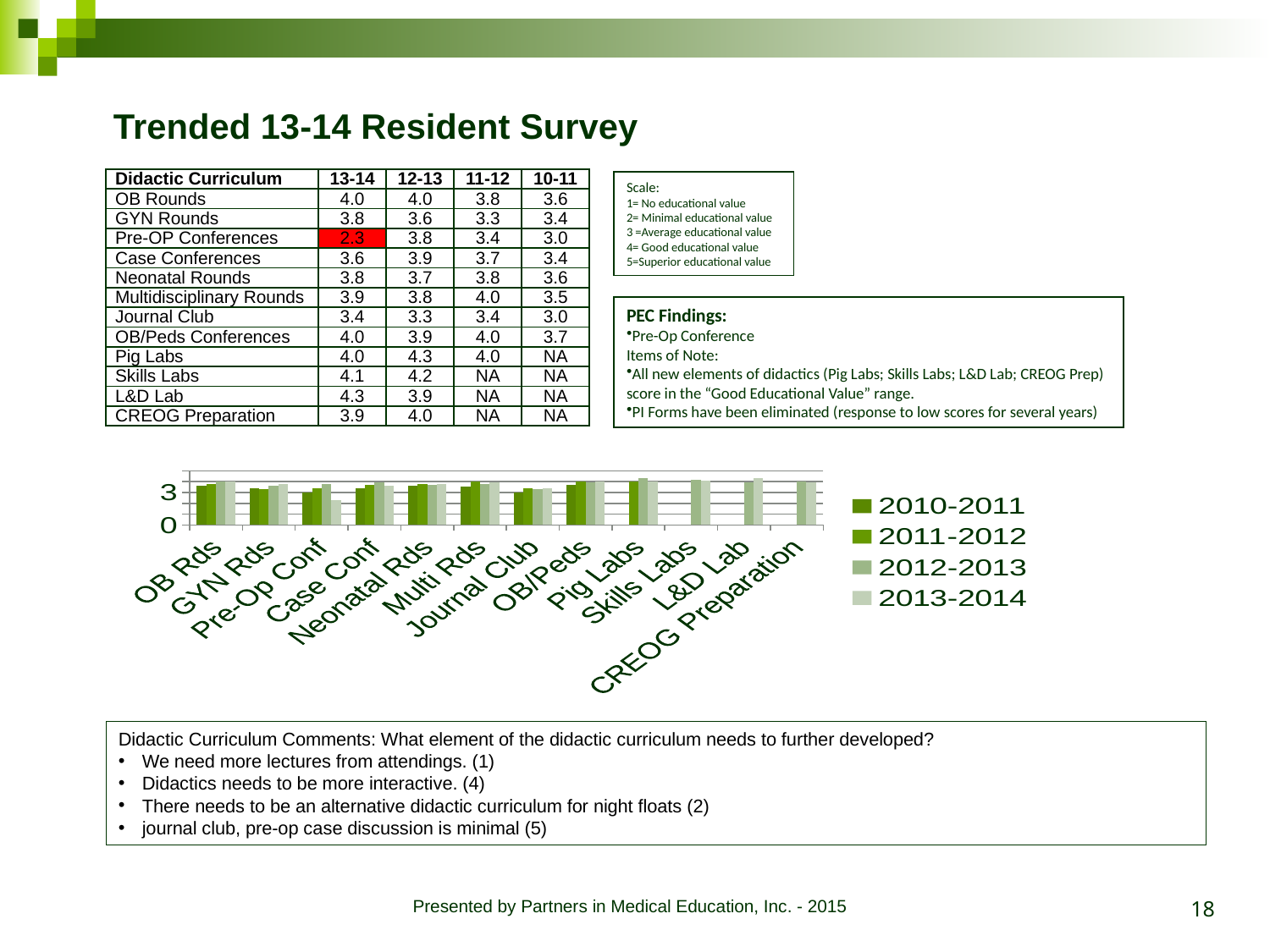
In the bar chart, is the 2013-2014 value for OB Rds greater or less than 3? greater In the bar chart, is the 2013-2014 value for Pre-Op Conf greater or less than 3? less How many categories in the bar chart have bars for only two of the four series? 3 How many categories are shown along the x axis of the bar chart? 12 In the bar chart, is the 2013-2014 value for L&D Lab greater or less than 3? greater In the bar chart, which category has the lowest 2013-2014 bar? Pre-Op Conf In the bar chart, which is larger for Pre-Op Conf: the 2012-2013 bar or the 2013-2014 bar? 2012-2013 How many series does the legend of the bar chart list? 4 Which categories in the bar chart have no bars for 2010-2011 and 2011-2012? Skills Labs, L&D Lab, CREOG Preparation What kind of chart is shown on the slide? bar chart In the bar chart, which is larger for 2013-2014: OB Rds or Pre-Op Conf? OB Rds What are the series names listed in the legend of the bar chart? 2010-2011, 2011-2012, 2012-2013, 2013-2014